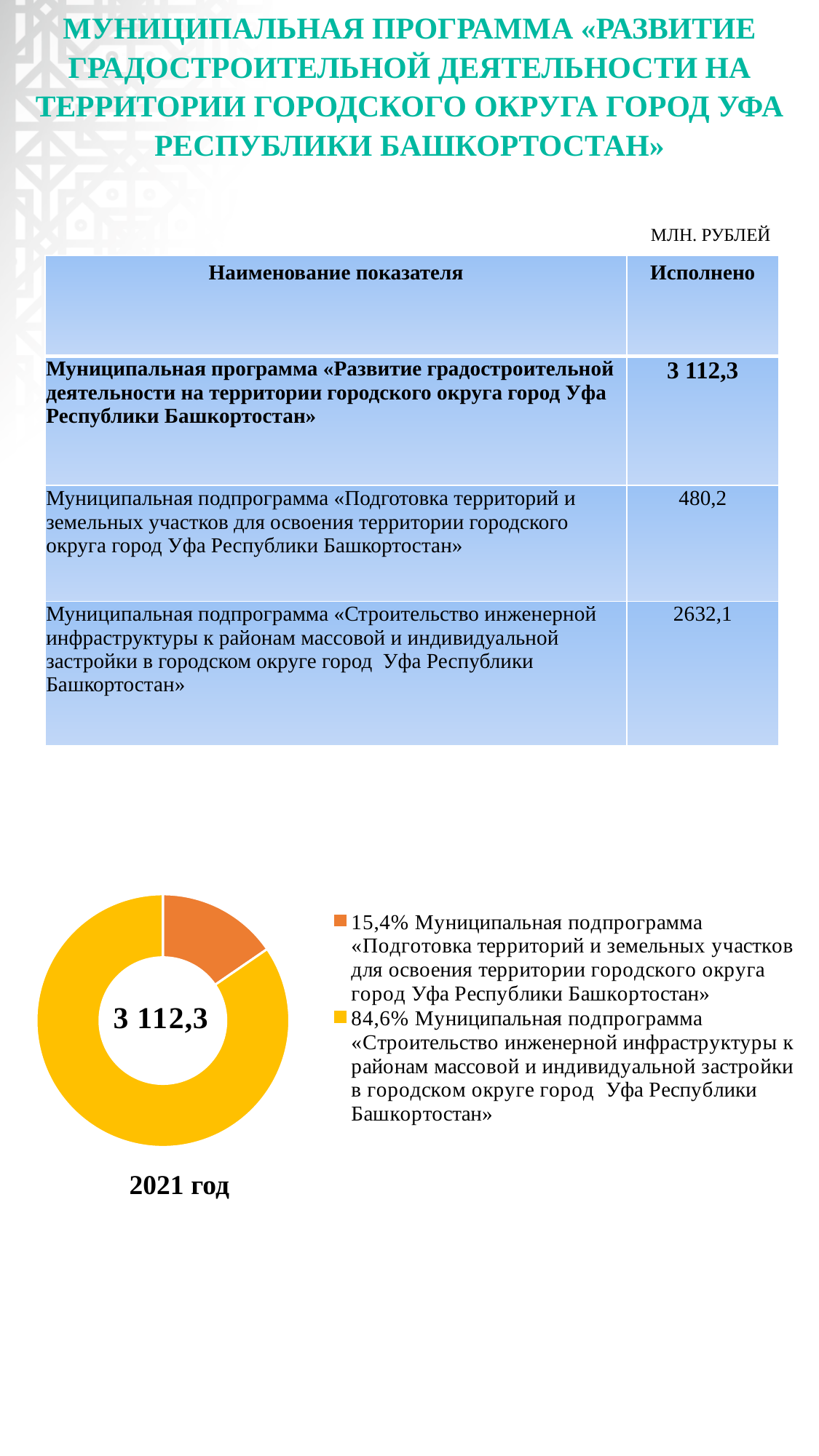
How many entries does the legend of the doughnut chart list? 2 What share of the doughnut chart does the subprogram «Подготовка территорий и земельных участков для освоения территории городского округа город Уфа Республики Башкортостан» take? 15,4% What year label is shown below the doughnut chart? 2021 год How many slices does the doughnut chart have? 2 What share of the doughnut chart does the subprogram «Строительство инженерной инфраструктуры к районам массовой и индивидуальной застройки в городском округе город Уфа Республики Башкортостан» take? 84,6% Which subprogram has the largest slice in the doughnut chart? Муниципальная подпрограмма «Строительство инженерной инфраструктуры к районам массовой и индивидуальной застройки в городском округе город Уфа Республики Башкортостан» What is the difference in percentage points between the two slices of the doughnut chart? 69,2% What kind of chart is shown on the slide? doughnut chart What colour is the slice for the subprogram «Подготовка территорий и земельных участков...» in the doughnut chart? orange Which slice is larger in the doughnut chart: «Подготовка территорий и земельных участков...» or «Строительство инженерной инфраструктуры...»? «Строительство инженерной инфраструктуры...» What value is printed in the centre of the doughnut chart? 3 112,3 Which subprogram has the smallest slice in the doughnut chart? Муниципальная подпрограмма «Подготовка территорий и земельных участков для освоения территории городского округа город Уфа Республики Башкортостан»